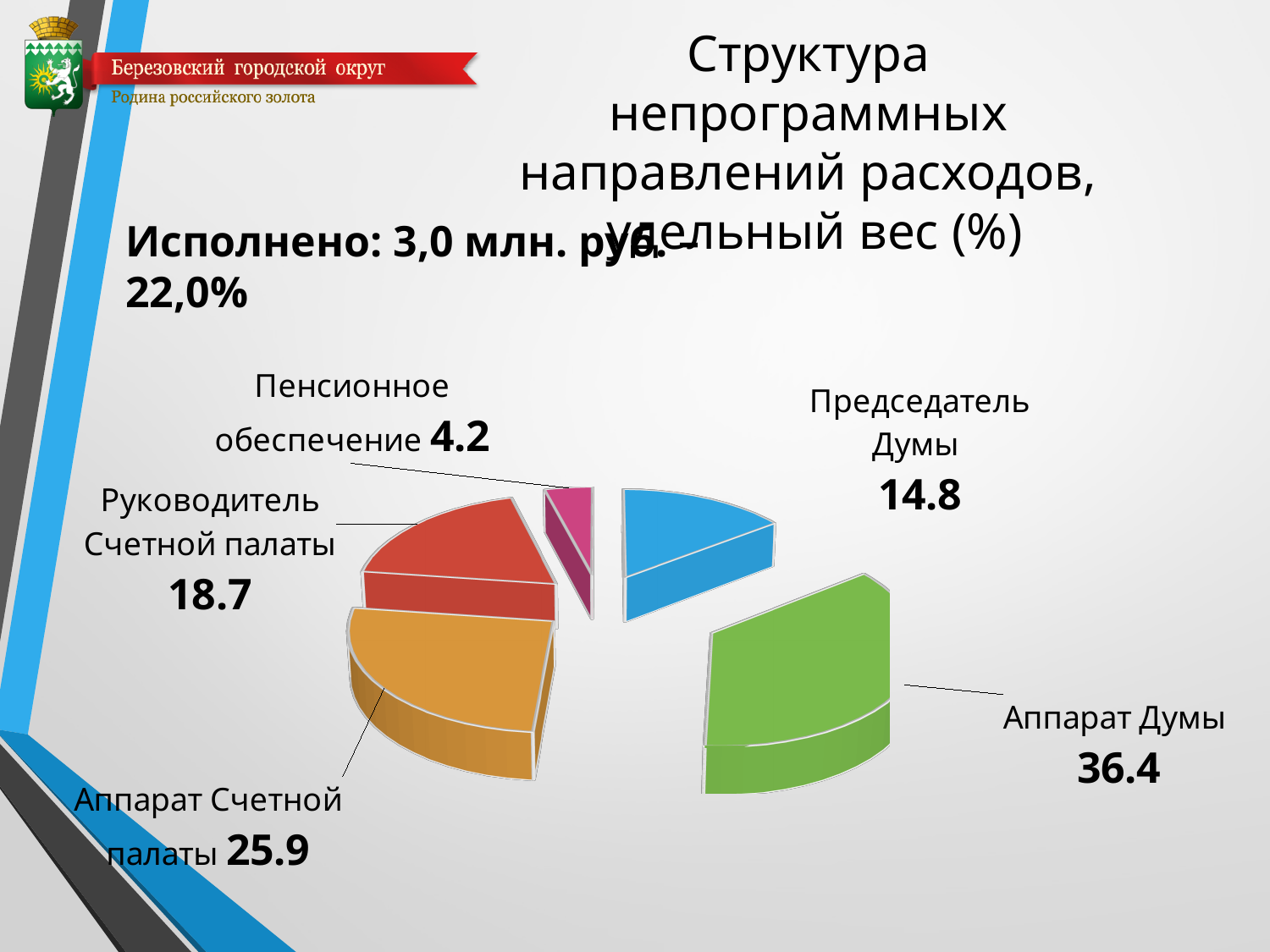
What is the title of the chart? Структура непрограммных направлений расходов, удельный вес (%) What colour is the slice for Аппарат Счетной палаты? Orange Which is larger: Руководитель Счетной палаты or Председатель Думы? Руководитель Счетной палаты What is the value for Аппарат Думы? 36.4 What is the difference between the values for Аппарат Думы and Аппарат Счетной палаты? 10.5 What is the value for Председатель Думы? 14.8 What is the value for Пенсионное обеспечение? 4.2 Which category has the largest share of the pie? Аппарат Думы Which category has the smallest share of the pie? Пенсионное обеспечение What is the value for Руководитель Счетной палаты? 18.7 What type of chart is shown on the slide? Pie chart How many slices does the pie chart have? 5